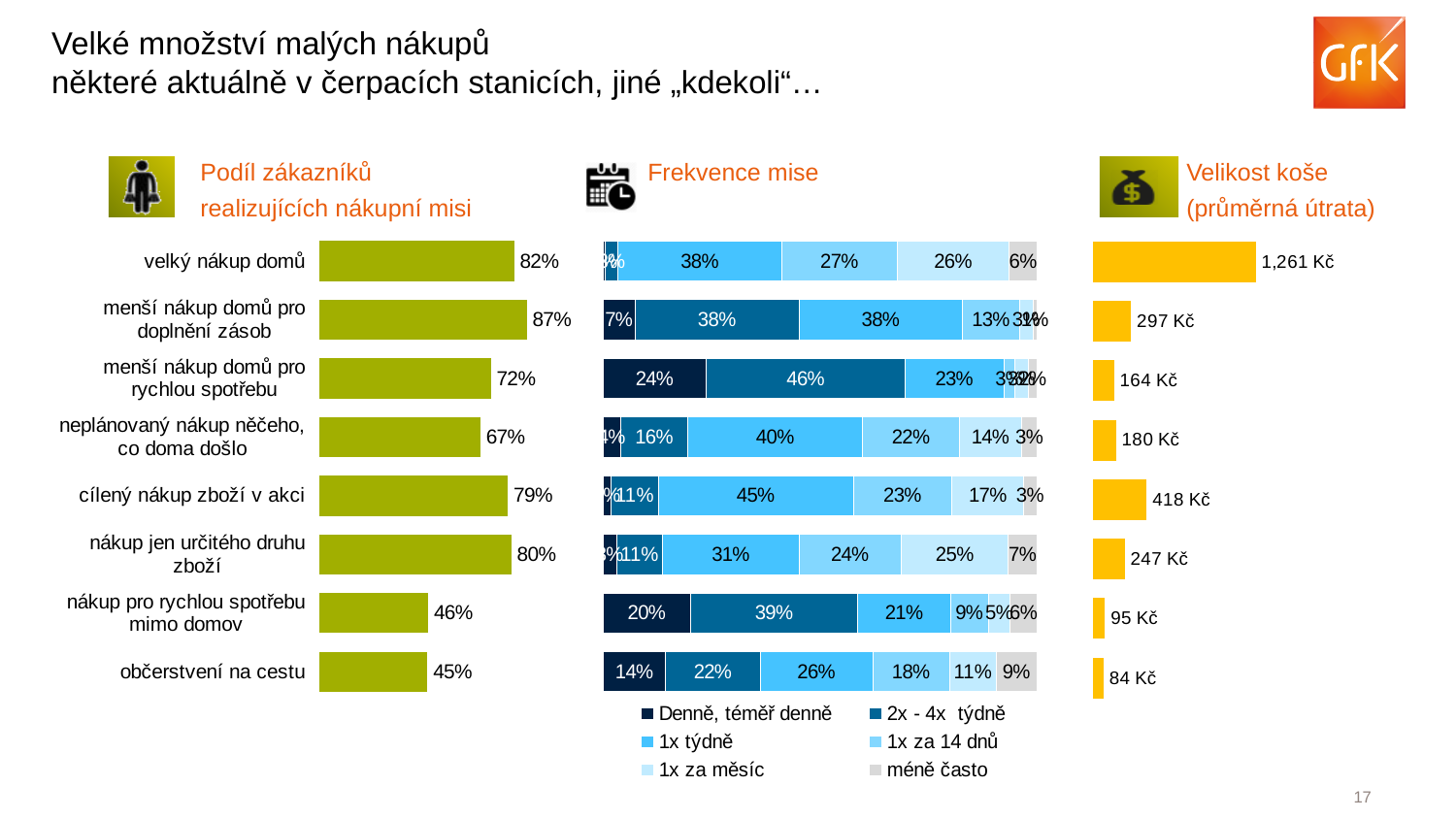
In the chart "Velikost koše (průměrná útrata)", which is larger: "cílený nákup zboží v akci" or "menší nákup domů pro doplnění zásob"? cílený nákup zboží v akci In the chart "Velikost koše (průměrná útrata)", what is the value for "velký nákup domů"? 1,261 Kč In the chart "Podíl zákazníků realizujících nákupní misi", what is the difference between "velký nákup domů" and "občerstvení na cestu"? 37 percentage points In the chart "Podíl zákazníků realizujících nákupní misi", which category has the highest value? menší nákup domů pro doplnění zásob In the chart "Frekvence mise", what is the value of "Denně, téměř denně" for "občerstvení na cestu"? 14% How many series does the legend of the chart "Frekvence mise" list? 6 In the chart "Podíl zákazníků realizujících nákupní misi", which category has the lowest value? občerstvení na cestu In the chart "Velikost koše (průměrná útrata)", what is the value for "nákup pro rychlou spotřebu mimo domov"? 95 Kč What kind of chart is "Frekvence mise"? stacked bar chart How many categories are shown in the chart "Podíl zákazníků realizujících nákupní misi"? 8 In the chart "Podíl zákazníků realizujících nákupní misi", what is the value for "menší nákup domů pro doplnění zásob"? 87% In the chart "Velikost koše (průměrná útrata)", which category has the lowest value? občerstvení na cestu